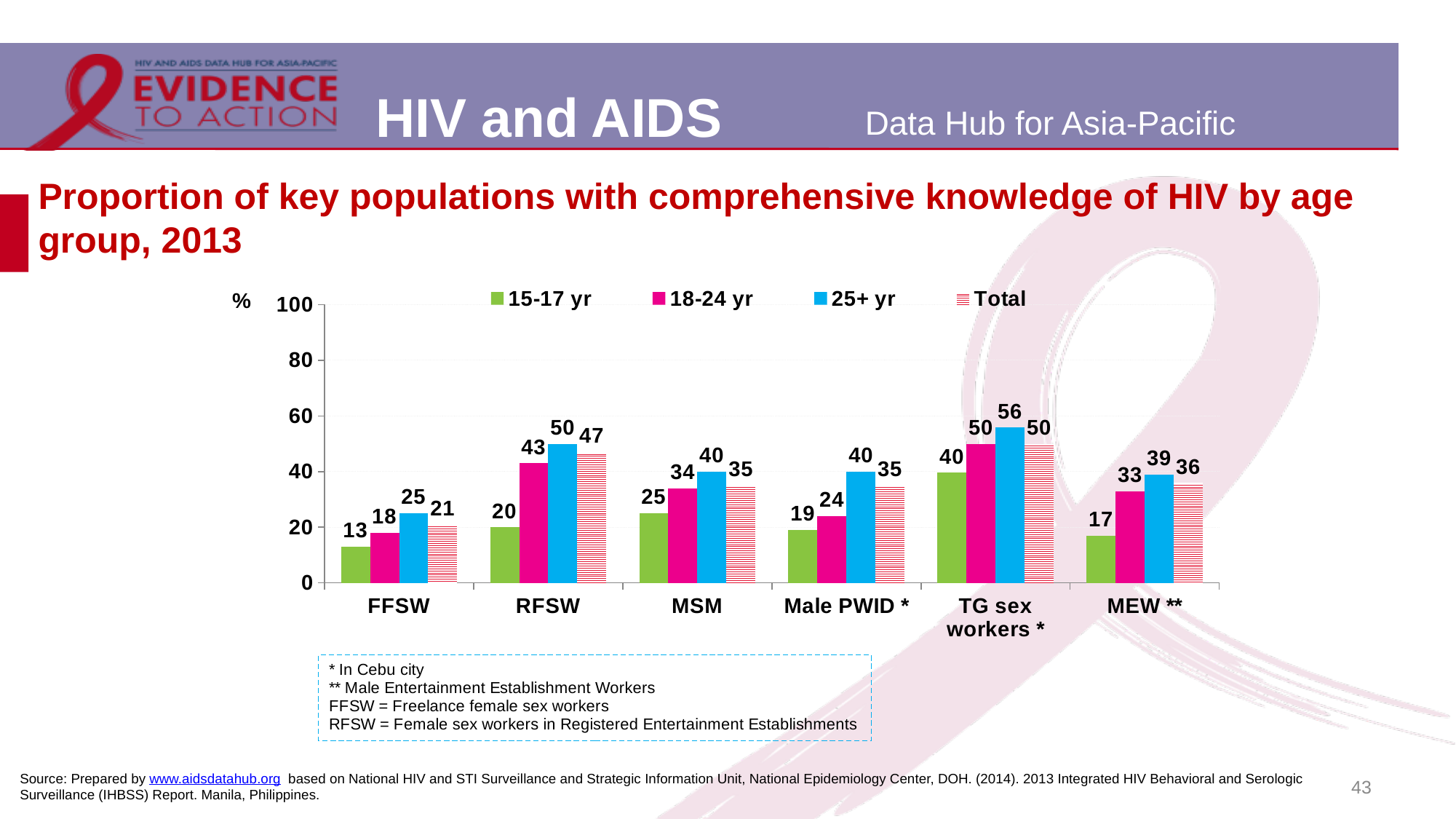
What colour represents the 25+ yr series in the legend? Blue What is the Total value for the RFSW category? 47 How many categories are shown on the x axis? 6 How many series does the legend list? 4 What is the value for the 25+ yr series in the TG sex workers * category? 56 What kind of chart is shown on the slide? Bar chart Which is larger: the 18-24 yr value for RFSW or the 18-24 yr value for MSM? RFSW What is the difference between the 25+ yr and 15-17 yr values in the Male PWID * category? 21 Which category has the lowest Total value? FFSW What is the value for the 15-17 yr series in the FFSW category? 13 What is the value for the 18-24 yr series in the MEW ** category? 33 Which category has the highest value for the 25+ yr series? TG sex workers *